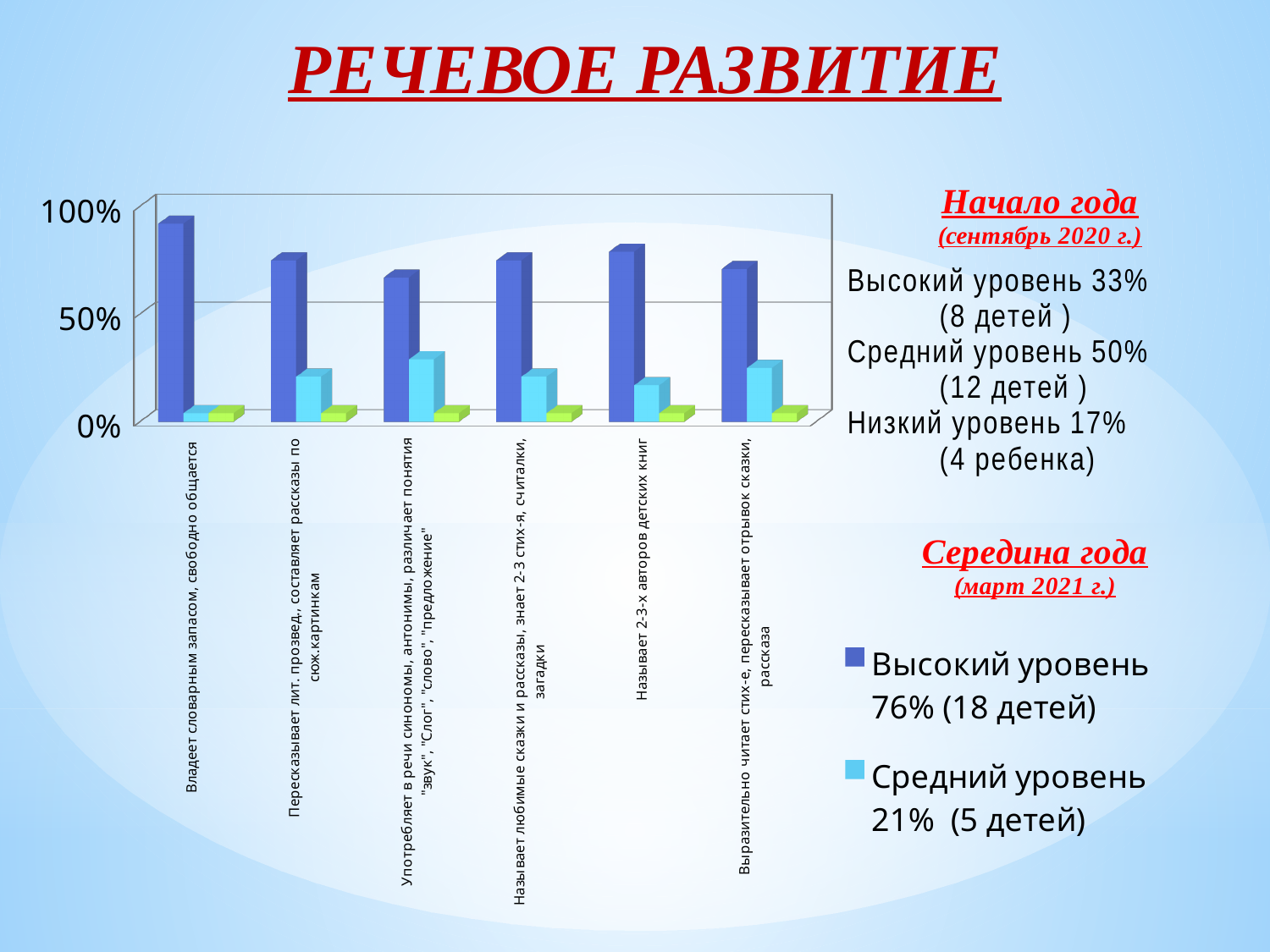
How many series does the legend on the right of the slide list? 2 Which series does the dark blue colour represent according to the legend? Высокий уровень What kind of chart is shown on the slide? bar chart How many categories are shown along the x axis of the chart? 6 Is the light blue (Средний уровень) value for "Называет 2-3-х авторов детских книг" greater or less than 50%? less For "Пересказывает лит. произвед., составляет рассказы по сюж.картинкам", which is larger: the dark blue (Высокий уровень) bar or the light blue (Средний уровень) bar? dark blue (Высокий уровень) Is the dark blue (Высокий уровень) value for "Употребляет в речи синонимы, антонимы, различает понятия" greater or less than 50%? greater Which category has the lowest light blue (Средний уровень) bar? Владеет словарным запасом, свободно общается Which dark blue (Высокий уровень) bar is taller: "Владеет словарным запасом, свободно общается" or "Употребляет в речи синонимы, антонимы, различает понятия"? Владеет словарным запасом, свободно общается Which category has the highest dark blue (Высокий уровень) bar? Владеет словарным запасом, свободно общается Is the dark blue (Высокий уровень) value for "Владеет словарным запасом, свободно общается" greater or less than 50%? greater What is the title of the slide containing the chart? РЕЧЕВОЕ РАЗВИТИЕ